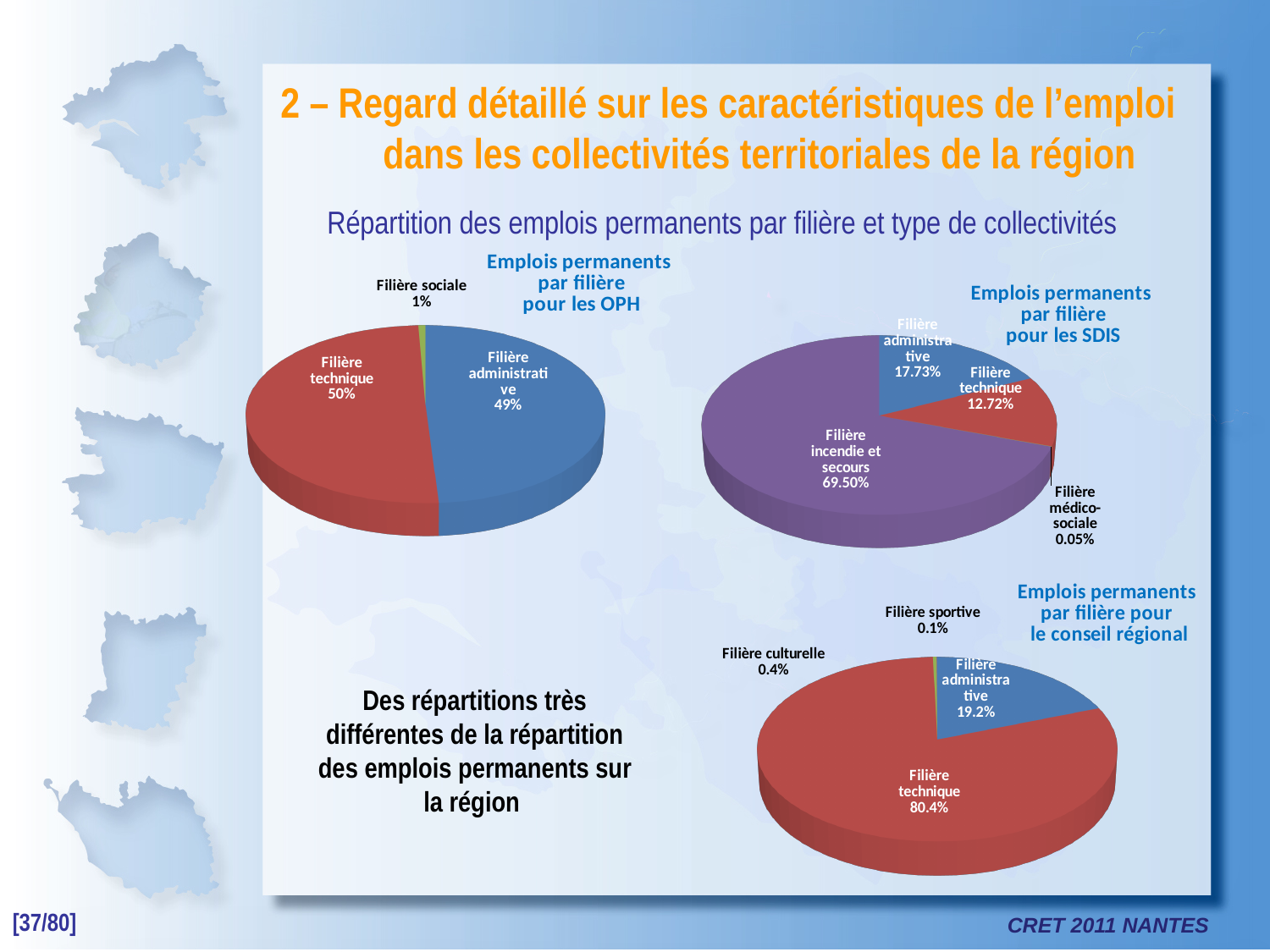
What kind of chart is 'Emplois permanents par filière pour les OPH'? Pie chart In the chart 'Emplois permanents par filière pour les OPH', what share is Filière technique? 50% In the chart 'Emplois permanents par filière pour le conseil régional', which is larger, Filière administrative or Filière technique? Filière technique In the chart 'Emplois permanents par filière pour les SDIS', what share is Filière incendie et secours? 69.50% How many slices does the chart 'Emplois permanents par filière pour les SDIS' have? 4 In the chart 'Emplois permanents par filière pour le conseil régional', what share is Filière technique? 80.4% In the chart 'Emplois permanents par filière pour les SDIS', what is the difference between Filière administrative and Filière technique? 5.01% In the chart 'Emplois permanents par filière pour le conseil régional', what share is Filière culturelle? 0.4% In the chart 'Emplois permanents par filière pour les SDIS', which filière has the smallest share? Filière médico-sociale How many pie charts are shown on the slide? 3 In the chart 'Emplois permanents par filière pour les OPH', what share is Filière sociale? 1% In the chart 'Emplois permanents par filière pour les SDIS', which filière has the largest share? Filière incendie et secours